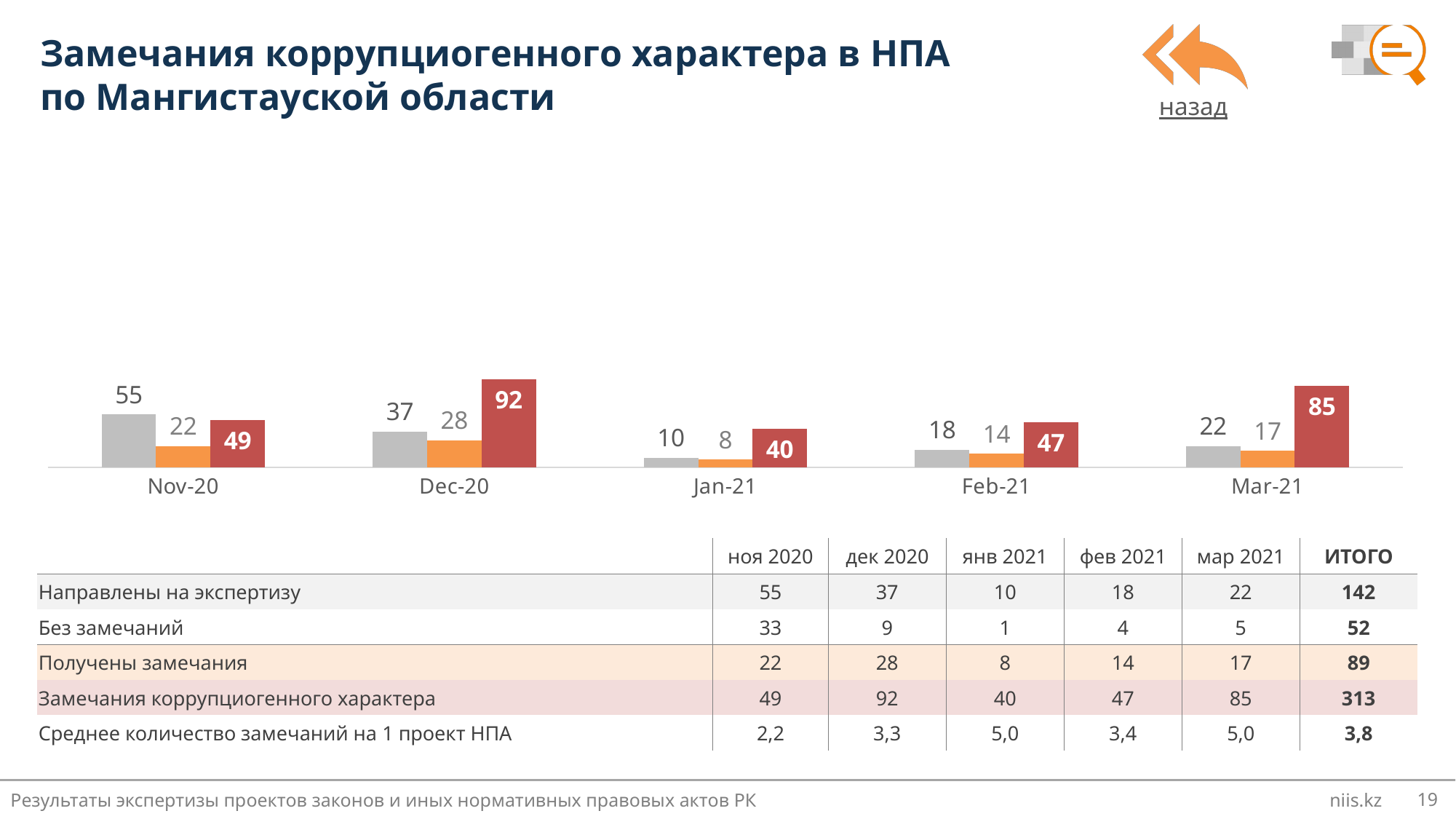
In which month is the red bar (Замечания коррупциогенного характера) highest? Dec-20 What kind of chart is shown on the slide? bar chart What is the value of the orange bar (Получены замечания) for Feb-21? 14 What is the value of the gray bar (Направлены на экспертизу) for Nov-20? 55 What is the difference between the gray bar and the orange bar for Nov-20? 33 Which colour are the bars showing Замечания коррупциогенного характера in the chart? red What is the value of the red bar (Замечания коррупциогенного характера) for Dec-20? 92 Which is larger: the gray bar for Nov-20 or the gray bar for Mar-21? Nov-20 In which month is the gray bar (Направлены на экспертизу) lowest? Jan-21 What is the difference between the red bar values for Dec-20 and Jan-21? 52 Does the red bar (Замечания коррупциогенного характера) rise or fall from Feb-21 to Mar-21? rise How many months (categories) are shown on the x axis of the chart? 5